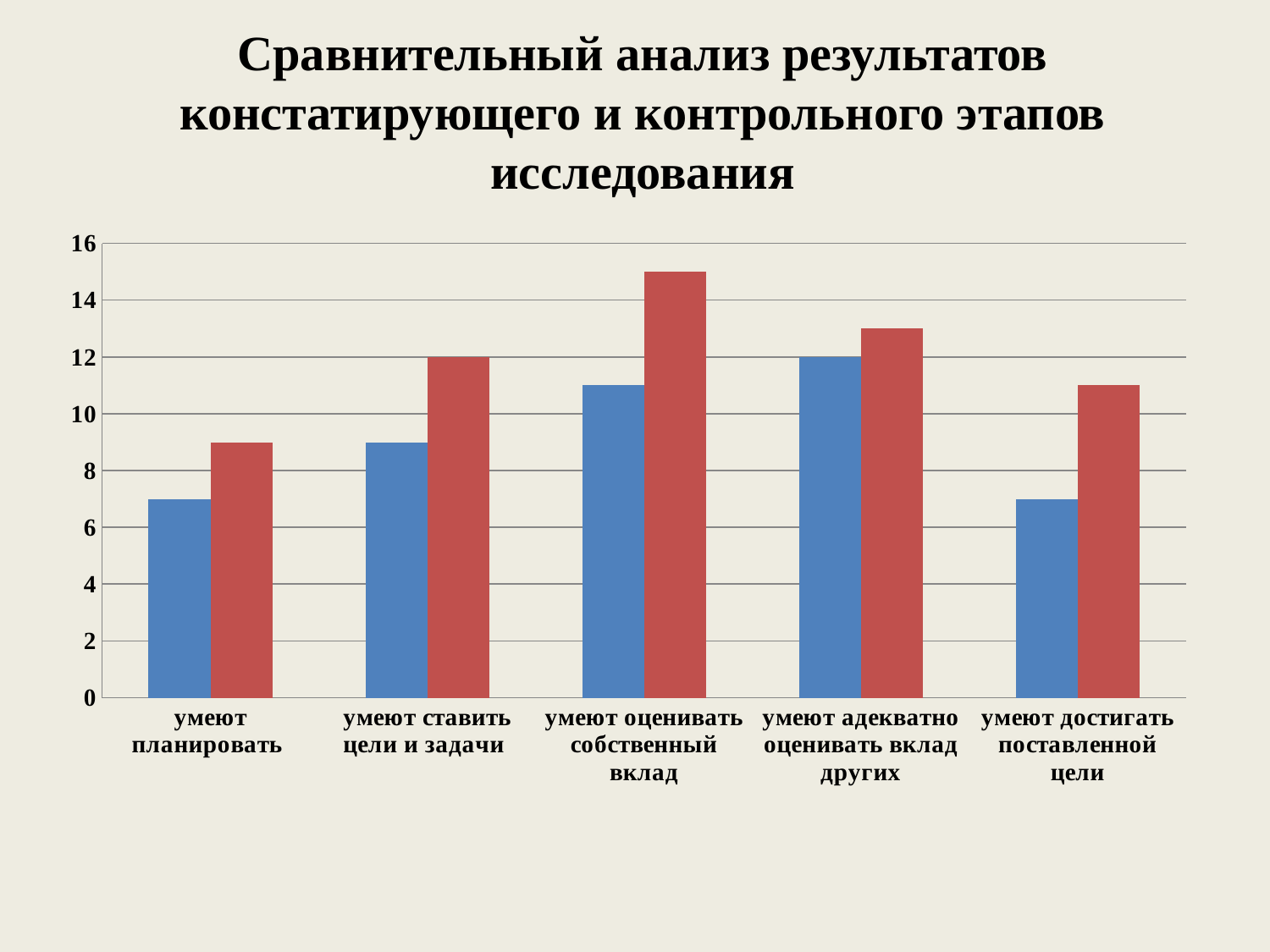
Is the value of the blue bar for "умеют ставить цели и задачи" greater or less than 10? less Among the blue bars, which category has the highest value? умеют адекватно оценивать вклад других What is the title of the chart on the slide? Сравнительный анализ результатов констатирующего и контрольного этапов исследования Is the value of the red bar for "умеют оценивать собственный вклад" greater or less than 14? greater What kind of chart is shown on the slide? bar chart What is the value of the blue bar for "умеют адекватно оценивать вклад других"? 12 For "умеют планировать", which bar is taller, the blue one or the red one? the red one Among the red bars, which category has the lowest value? умеют планировать Which category has the tallest bar in the chart? умеют оценивать собственный вклад How many categories are shown along the x axis? 5 What is the value of the red bar for "умеют ставить цели и задачи"? 12 Is the value of the blue bar for "умеют планировать" greater or less than 8? less